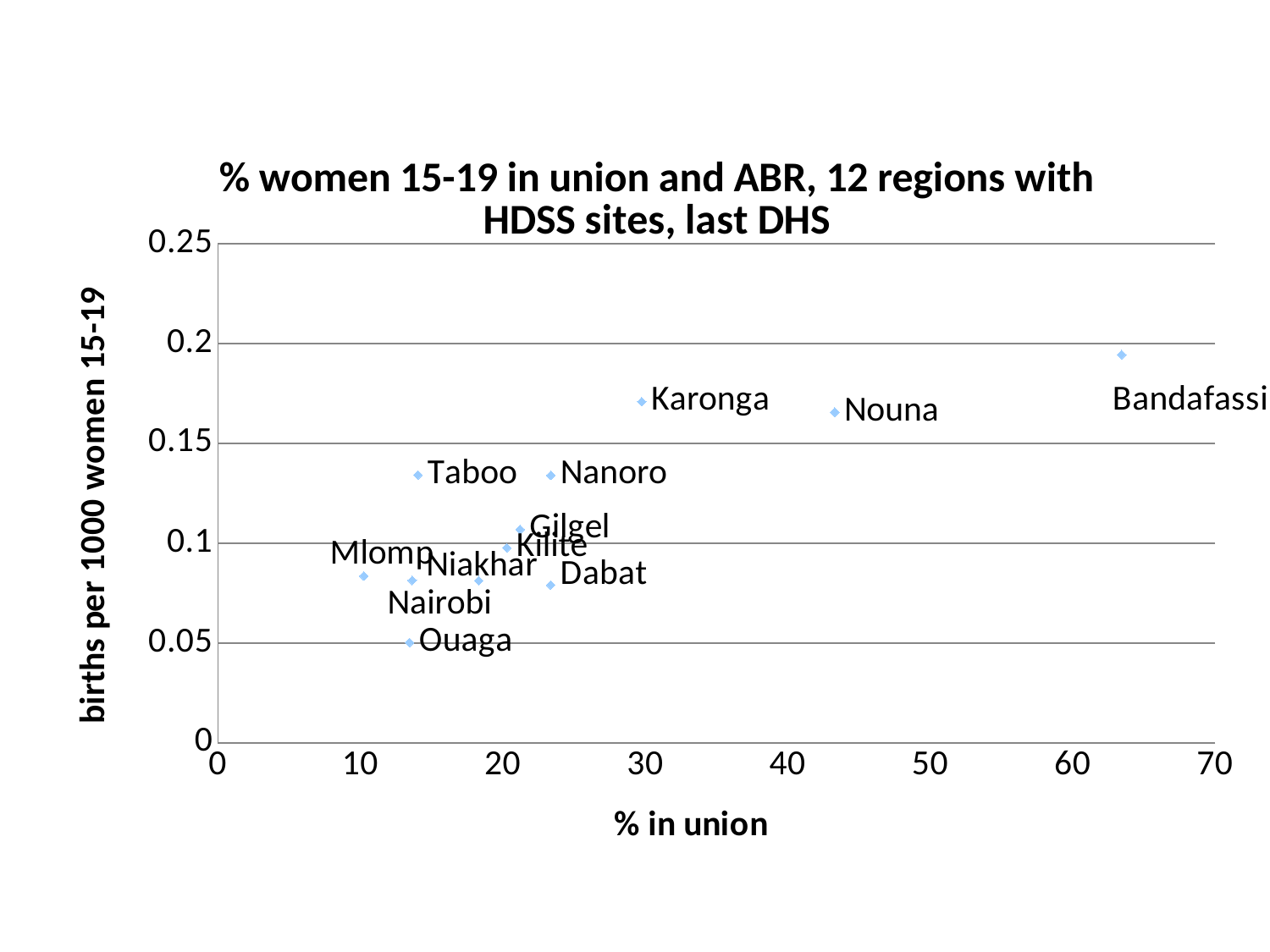
Which region has the highest births per 1000 women 15-19? Bandafassi Which region has the lowest % in union? Mlomp Is the births per 1000 women 15-19 value for Karonga greater or less than 0.15? greater Which region has a higher births per 1000 women 15-19 value, Karonga or Ouaga? Karonga Is the % in union for Nouna greater or less than 40? greater Which region has the highest % in union? Bandafassi Is the births per 1000 women 15-19 value for Ouaga greater or less than 0.1? less Which region has the lowest births per 1000 women 15-19? Ouaga What kind of chart is shown on the slide? scatter chart How many regions (data points) are plotted on the chart? 12 What is the label of the x axis? % in union